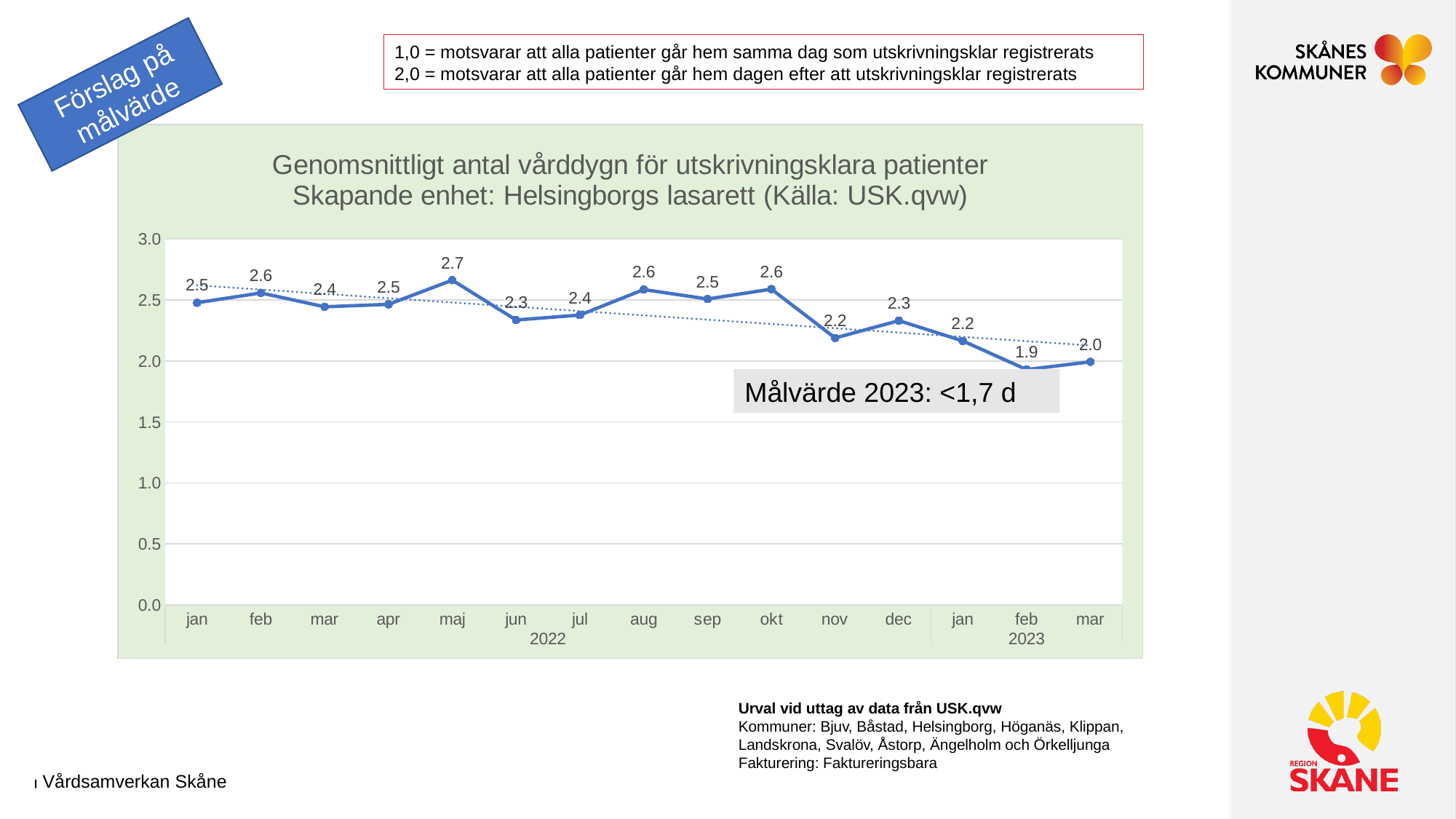
Which month has the lowest value? feb 2023 What is the value for maj 2022? 2.7 Which is larger, the value for aug 2022 or the value for nov 2022? aug 2022 What is the value for mar 2023? 2.0 Do the values generally rise or fall from jan 2022 to mar 2023? fall What kind of chart is shown on the slide? line chart What is the value for nov 2022? 2.2 Is the value for feb 2023 greater or less than 2.0? less What is the difference between the value for maj 2022 and the value for feb 2023? 0.8 How many monthly data points are plotted on the chart? 15 What is the value for feb 2023? 1.9 Which month has the highest value? maj 2022